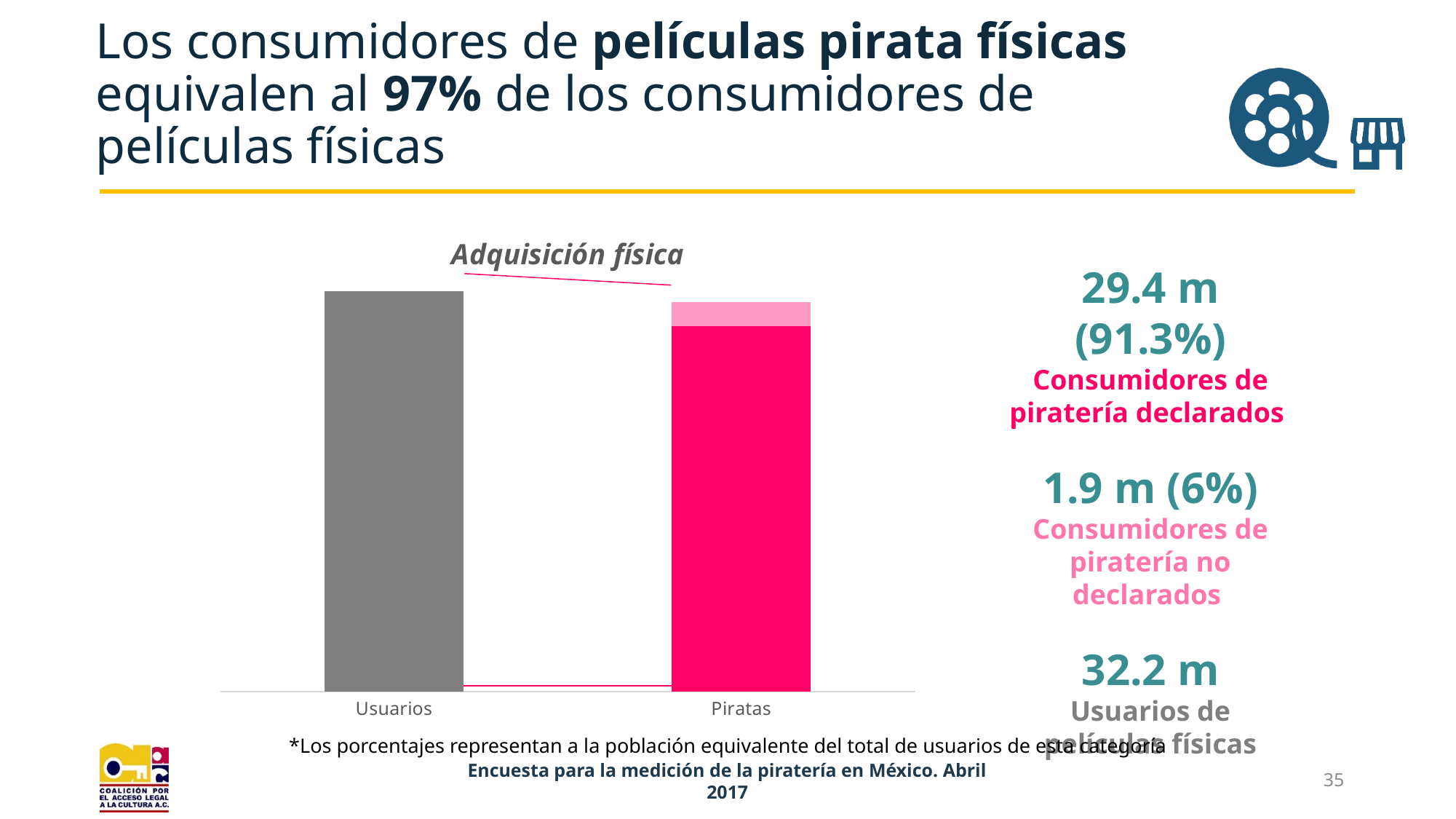
What is the title of the chart? Adquisición física What is the total of the stacked Piratas bar (declarados plus no declarados)? 31.3 m What percentage is shown for Consumidores de piratería declarados? 91.3% What is the value for Consumidores de piratería no declarados in the Piratas bar? 1.9 m What are the two category labels on the x axis of the chart? Usuarios and Piratas What percentage is shown for Consumidores de piratería no declarados? 6% Within the Piratas bar, which segment is larger: Consumidores de piratería declarados or Consumidores de piratería no declarados? Consumidores de piratería declarados How many categories are shown on the x axis of the chart? 2 What is the difference between the Usuarios value and the Consumidores de piratería declarados value? 2.8 m What is the value for Usuarios (Usuarios de películas físicas)? 32.2 m What kind of chart is shown on the slide? bar chart What is the value for Consumidores de piratería declarados in the Piratas bar? 29.4 m